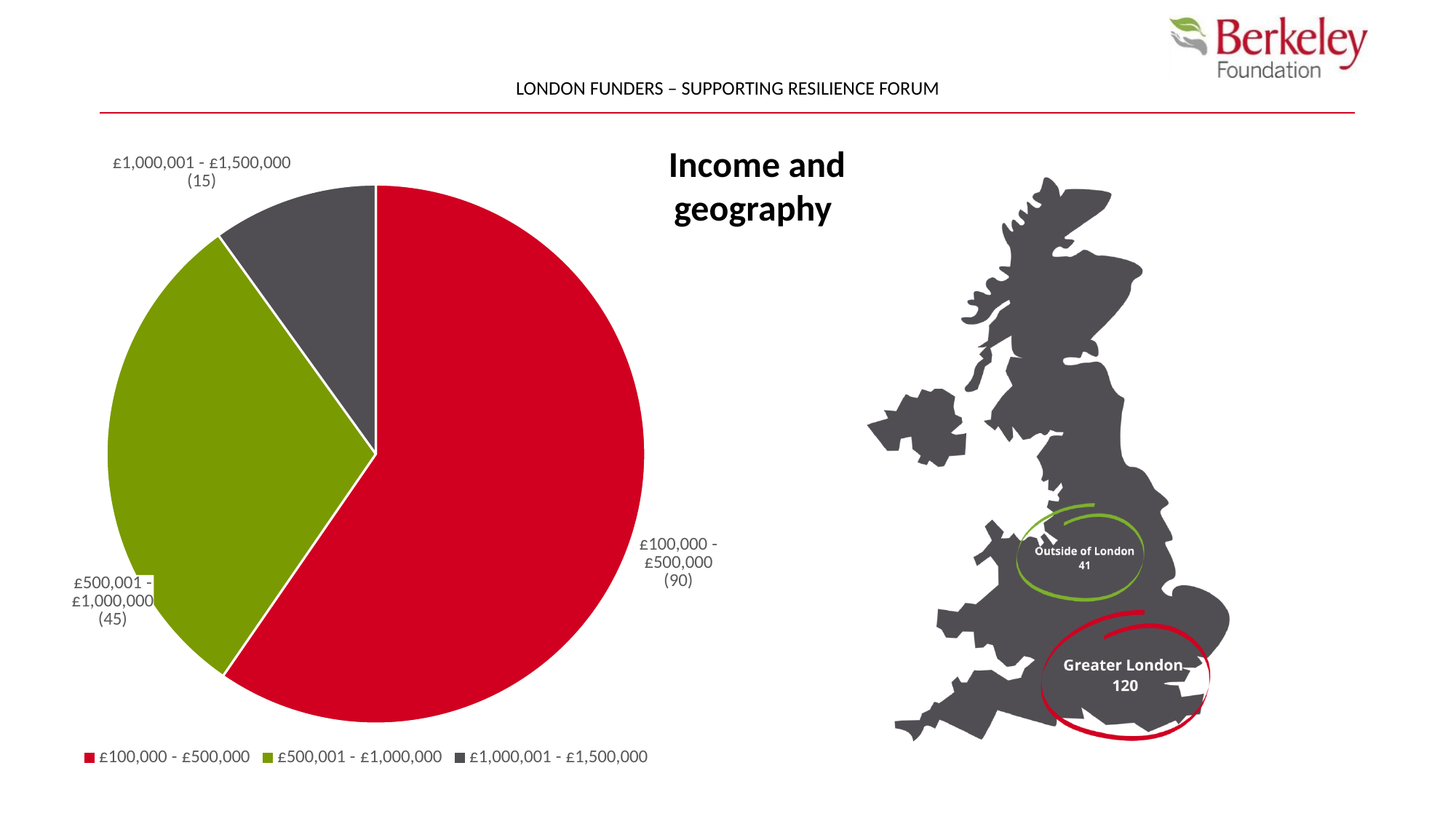
In the pie chart, what is the difference between the £100,000 - £500,000 value and the £500,001 - £1,000,000 value? 45 What share of the pie chart does the £1,000,001 - £1,500,000 slice represent? 10% How many categories does the pie chart show? 3 What colour is the £500,001 - £1,000,000 slice in the pie chart? green What share of the pie chart does the £100,000 - £500,000 slice represent? 60% Which category has the largest slice in the pie chart? £100,000 - £500,000 In the pie chart, what is the value for the £100,000 - £500,000 category? 90 What type of chart is shown on the left of the slide? pie chart In the pie chart, what is the value for the £1,000,001 - £1,500,000 category? 15 In the pie chart, what is the value for the £500,001 - £1,000,000 category? 45 Which category has the smallest slice in the pie chart? £1,000,001 - £1,500,000 In the pie chart, which is larger: the £500,001 - £1,000,000 slice or the £1,000,001 - £1,500,000 slice? £500,001 - £1,000,000